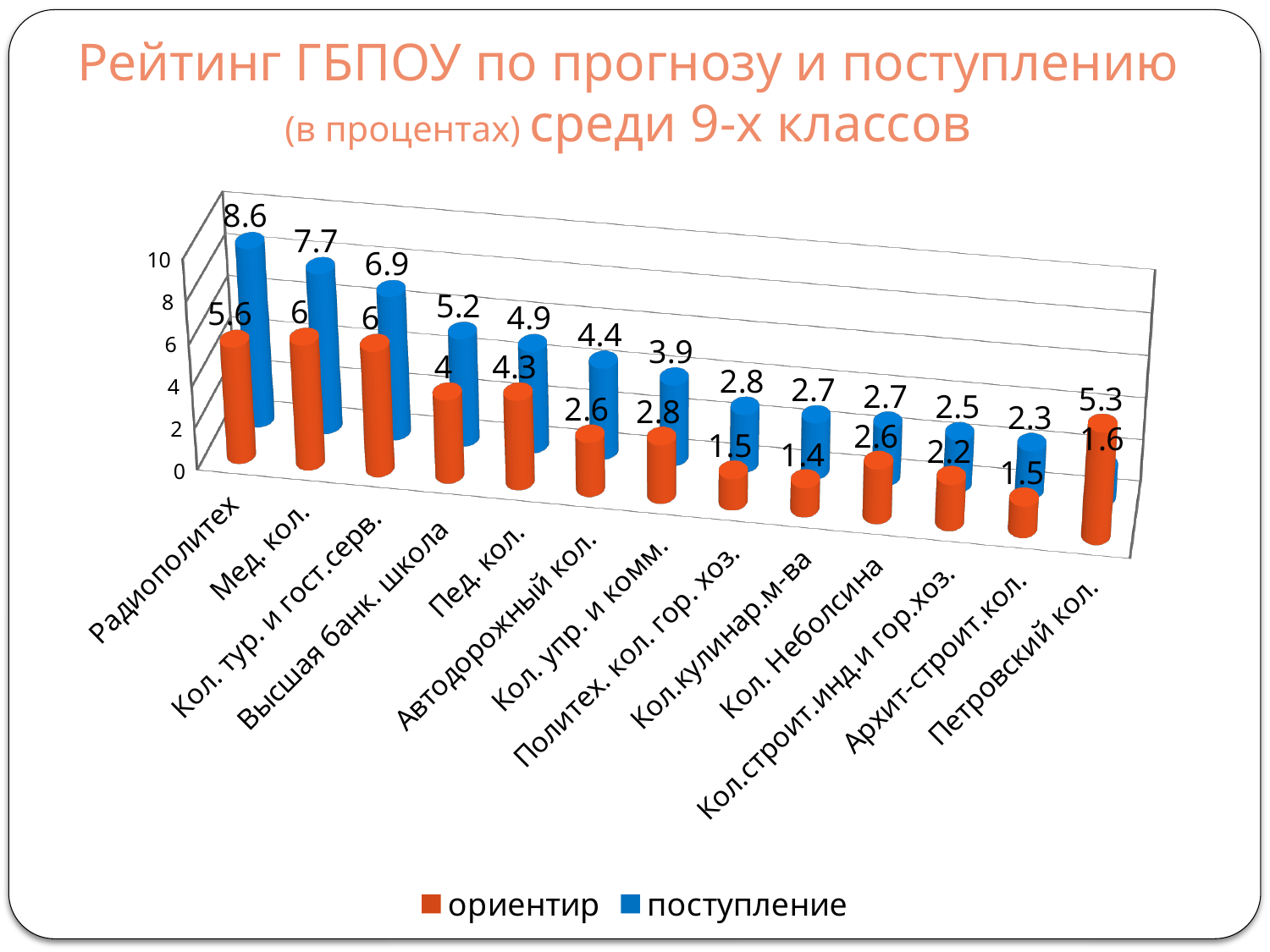
How many series does the legend list? 2 What is the поступление value for Радиополитех? 8.6 Which category has the lowest ориентир value? Кол.кулинар.м-ва What kind of chart is shown on the slide? bar chart What is the ориентир value for Петровский кол.? 5.3 Which category has the highest поступление value? Радиополитех How many categories are shown on the x axis? 13 What is the ориентир value for Пед. кол.? 4.3 Which colour represents the поступление series? blue What is the difference between the поступление and ориентир values for Радиополитех? 3 What is the поступление value for Автодорожный кол.? 4.4 Which is larger for Петровский кол.: the ориентир value or the поступление value? ориентир